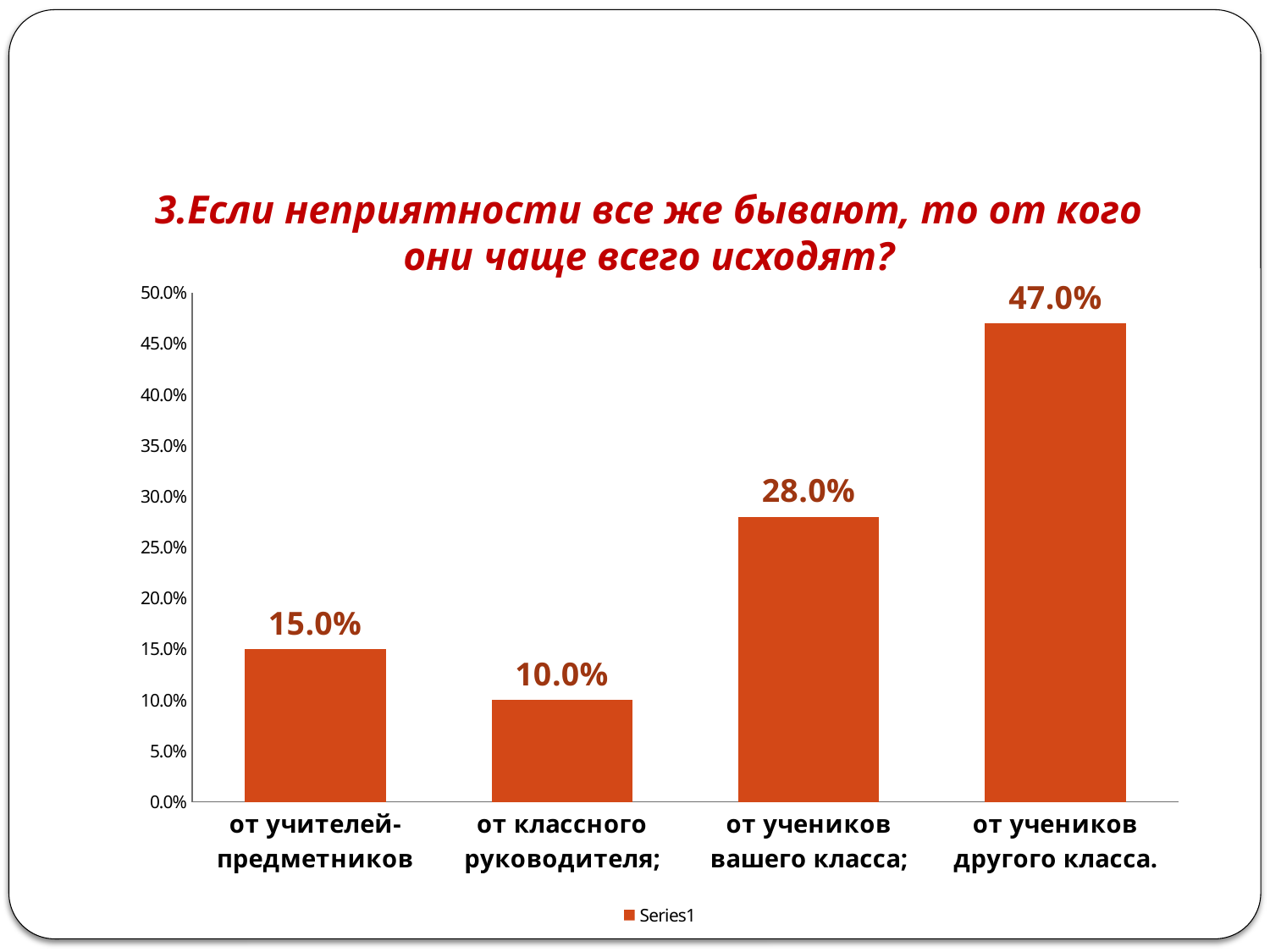
What is the value for "от учеников вашего класса;"? 28.0% Is the value for "от учеников вашего класса;" greater or less than 25.0%? greater Which is larger: the value for "от учителей-предметников" or for "от классного руководителя;"? от учителей-предметников Which category has the lowest value? от классного руководителя; What kind of chart is shown on the slide? bar chart What is the legend entry shown below the chart? Series1 How many categories are shown on the x axis? 4 What is the value for "от классного руководителя;"? 10.0% What is the value for "от учеников другого класса."? 47.0% Which category has the highest value? от учеников другого класса. What is the difference between the values for "от учеников другого класса." and "от учеников вашего класса;"? 19.0% What is the value for "от учителей-предметников"? 15.0%